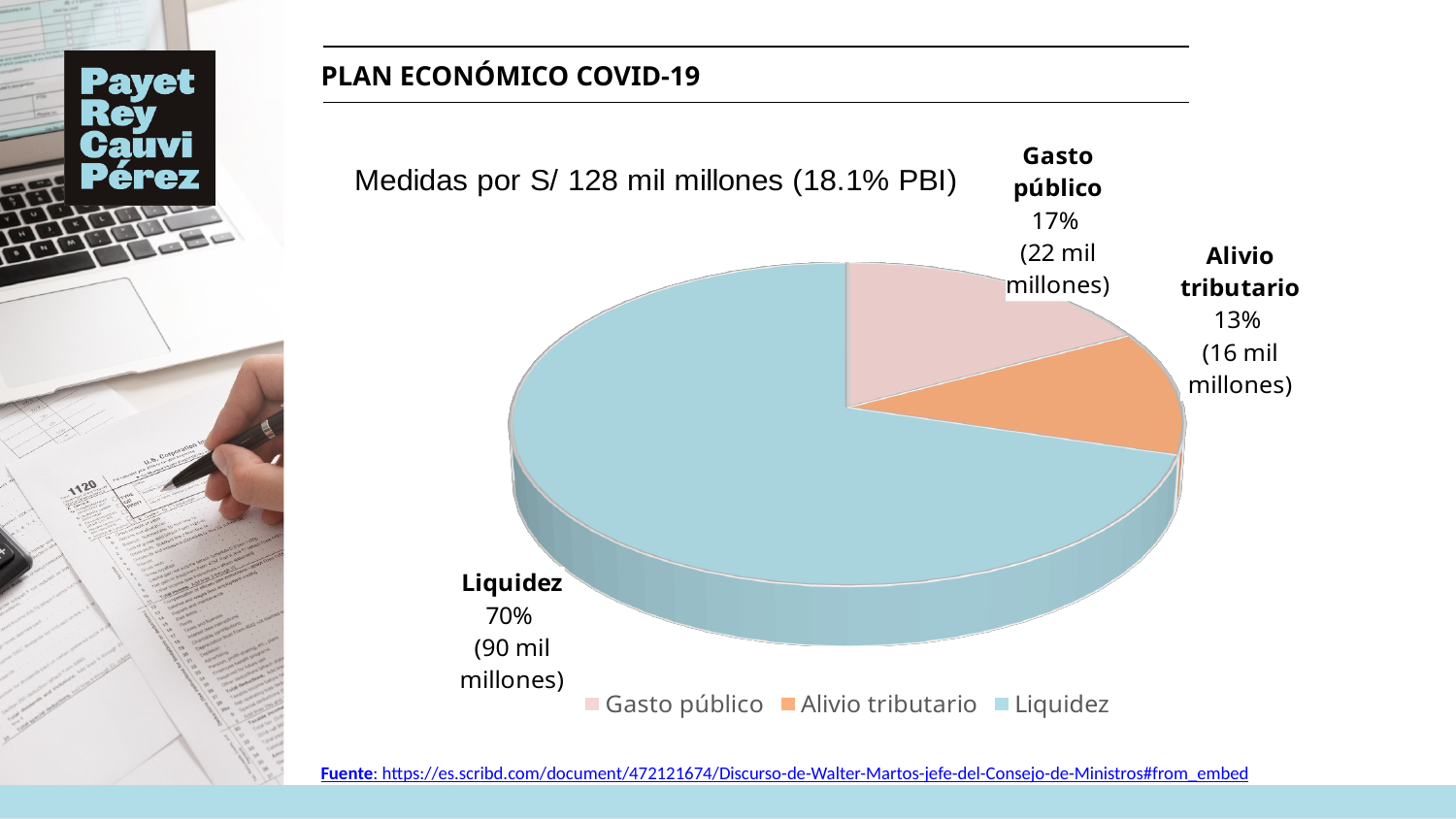
What percentage share does Liquidez have in the pie chart? 70% Which category has the largest slice in the pie chart? Liquidez Which is larger, the share for Gasto público or the share for Alivio tributario? Gasto público What percentage share does Alivio tributario have in the pie chart? 13% What is the difference in percentage points between Gasto público and Alivio tributario? 4 How many categories does the pie chart show? 3 What amount is shown for Liquidez in the pie chart? 90 mil millones What amount is shown for Alivio tributario in the pie chart? 16 mil millones What percentage share does Gasto público have in the pie chart? 17% What type of chart is shown on the slide? pie chart What amount is shown for Gasto público in the pie chart? 22 mil millones Which category has the smallest slice in the pie chart? Alivio tributario